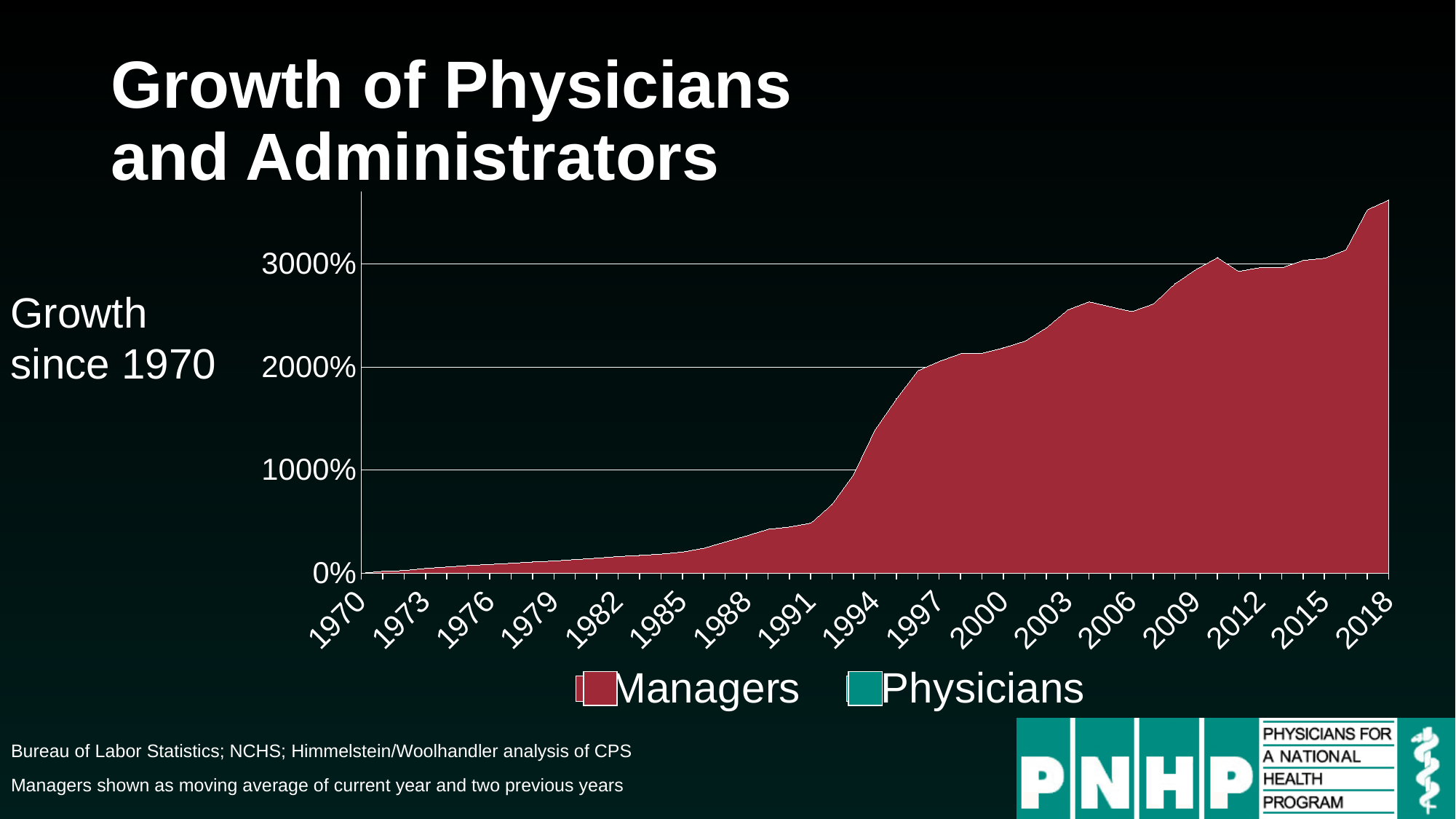
What is the title of the chart on the slide? Growth of Physicians and Administrators What are the two series named in the legend? Managers and Physicians In 2018, which series has the larger value, Managers or Physicians? Managers How many series does the legend list? 2 What kind of chart is shown on the slide? Area chart Does the Managers series generally rise or fall from 1970 to 2018? Rise How many year labels are shown along the x axis? 17 Is the value for Managers in 2006 greater or less than 3000%? less In which year does the Managers series reach its highest value? 2018 Is the value for Managers in 2018 greater or less than 3000%? greater Is the value for Managers in 1991 greater or less than 1000%? less